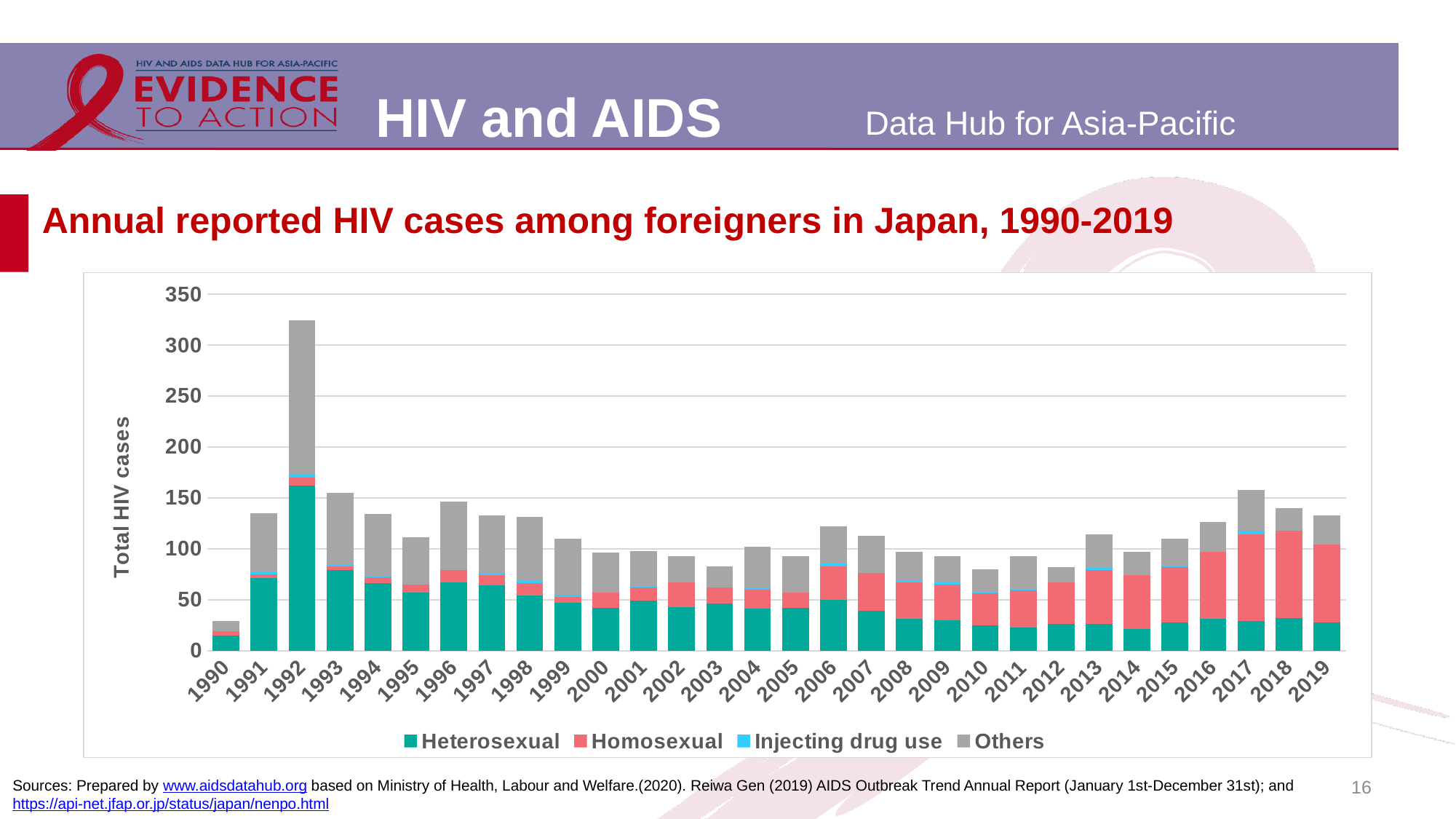
Is the total for 1992 greater or less than 300? greater Is the total for 2016 greater or less than 100? greater Is the total for 2010 greater or less than 100? less What is the title of the y axis? Total HIV cases What kind of chart is shown on the slide? Stacked bar chart How many years are shown along the x axis? 30 Which year has a larger total of reported HIV cases, 2017 or 2010? 2017 Which year has the lowest total of reported HIV cases? 1990 Which year has the highest total of reported HIV cases? 1992 Do the total reported HIV cases rise or fall from 2010 to 2017? Rise How many series does the legend list? 4